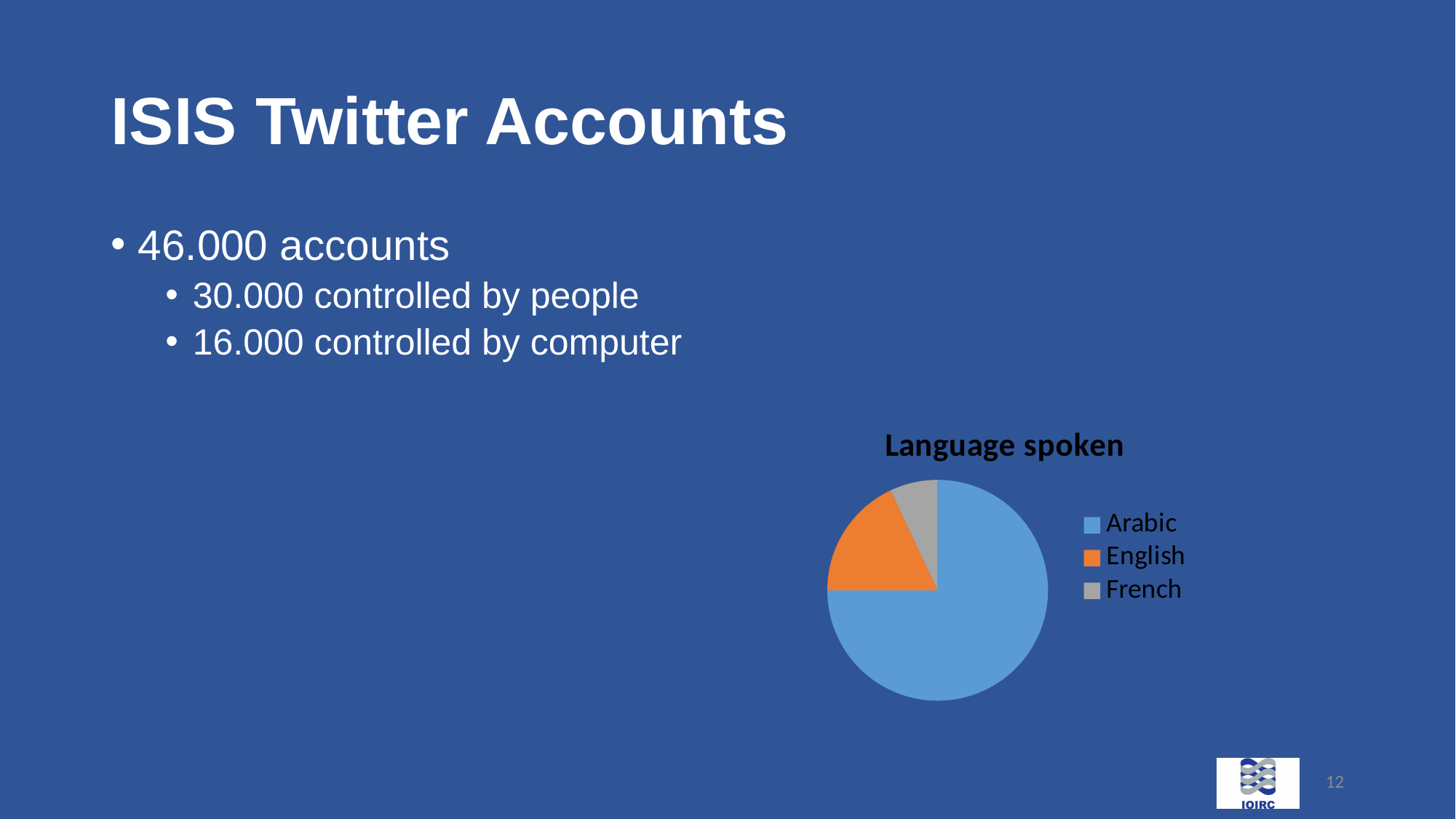
What is the title of the chart? Language spoken Which language has the smallest slice of the pie? French Which language has the largest slice of the pie? Arabic What kind of chart is shown on the slide? pie chart How many slices does the pie chart have? 3 Does Arabic account for more or less than half of the pie? more Which slice is larger, English or French? English Which colour represents English in the pie chart? orange Which slice is larger, Arabic or English? Arabic How many entries does the chart legend list? 3